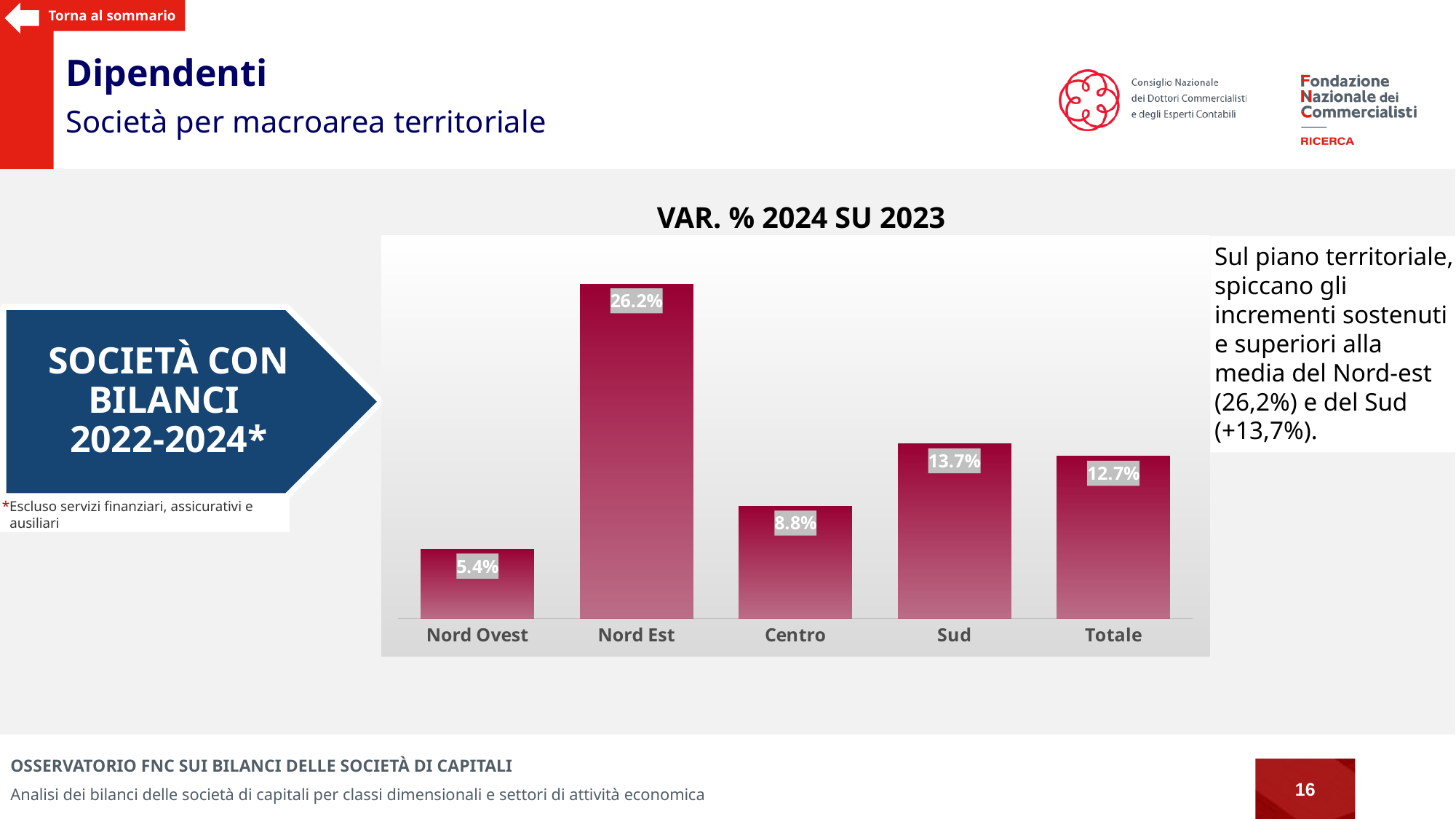
What is the value for Totale? 12.7% What is the title of the chart? VAR. % 2024 SU 2023 How many categories are shown on the x axis? 5 Which category has the highest value? Nord Est What is the value for Centro? 8.8% What is the value for Sud? 13.7% What is the value for Nord Ovest? 5.4% What is the value for Nord Est? 26.2% Which category has the lowest value? Nord Ovest What is the difference between the values for Nord Est and Nord Ovest? 20.8% What kind of chart is shown on the slide? Bar chart Which is larger, the value for Sud or the value for Centro? Sud